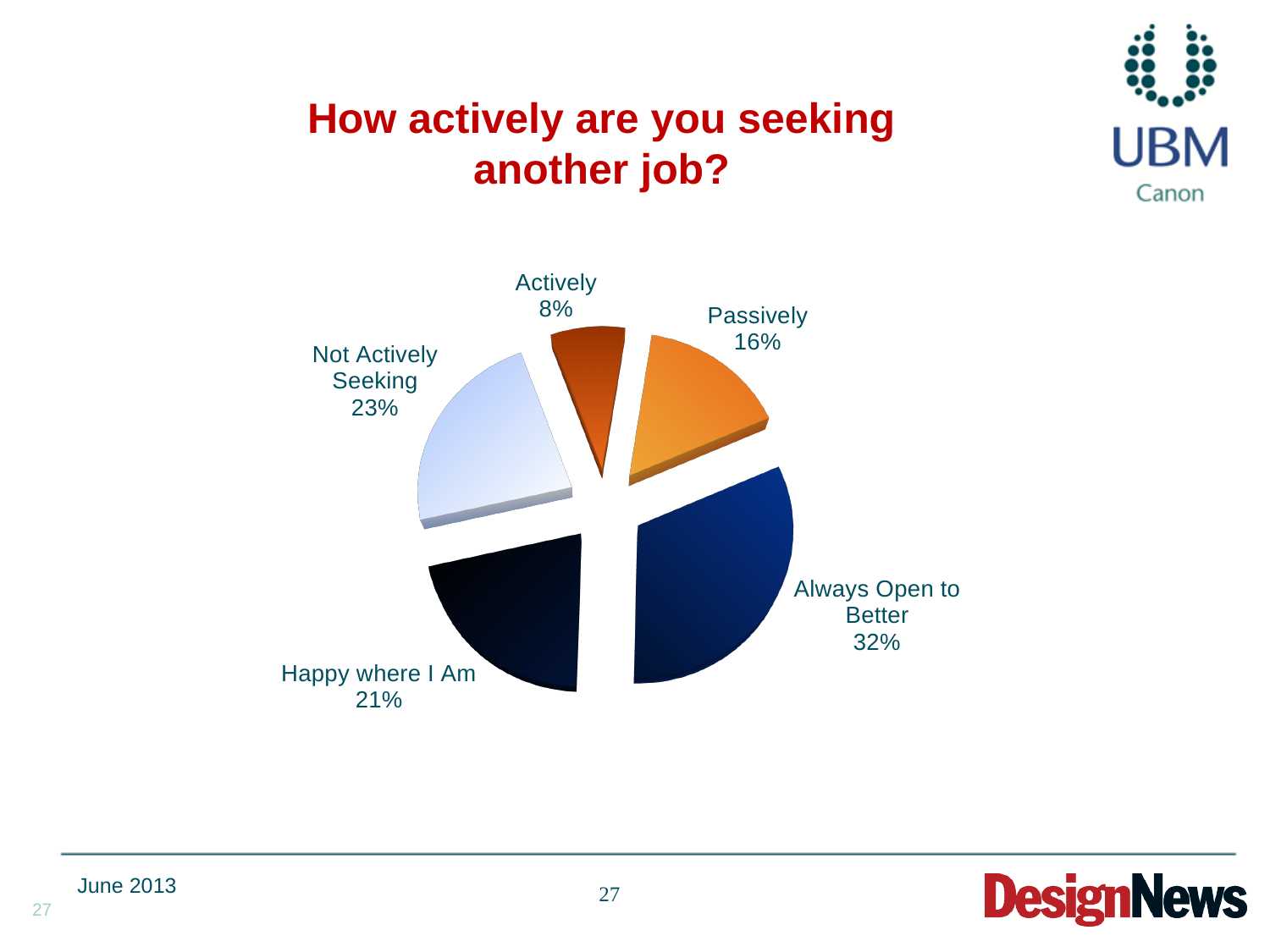
What percentage of respondents answered 'Passively'? 16% What is the difference in percentage points between 'Always Open to Better' and 'Actively'? 24 What percentage of respondents answered 'Always Open to Better'? 32% Which category has the largest share of the pie? Always Open to Better Which category has the smallest share of the pie? Actively What is the title of the chart? How actively are you seeking another job? Which is larger, 'Not Actively Seeking' or 'Happy where I Am'? Not Actively Seeking What percentage of respondents answered 'Not Actively Seeking'? 23% What percentage of respondents answered 'Happy where I Am'? 21% What kind of chart is shown on the slide? pie chart How many categories are shown in the pie chart? 5 What percentage of respondents are 'Actively' seeking another job? 8%